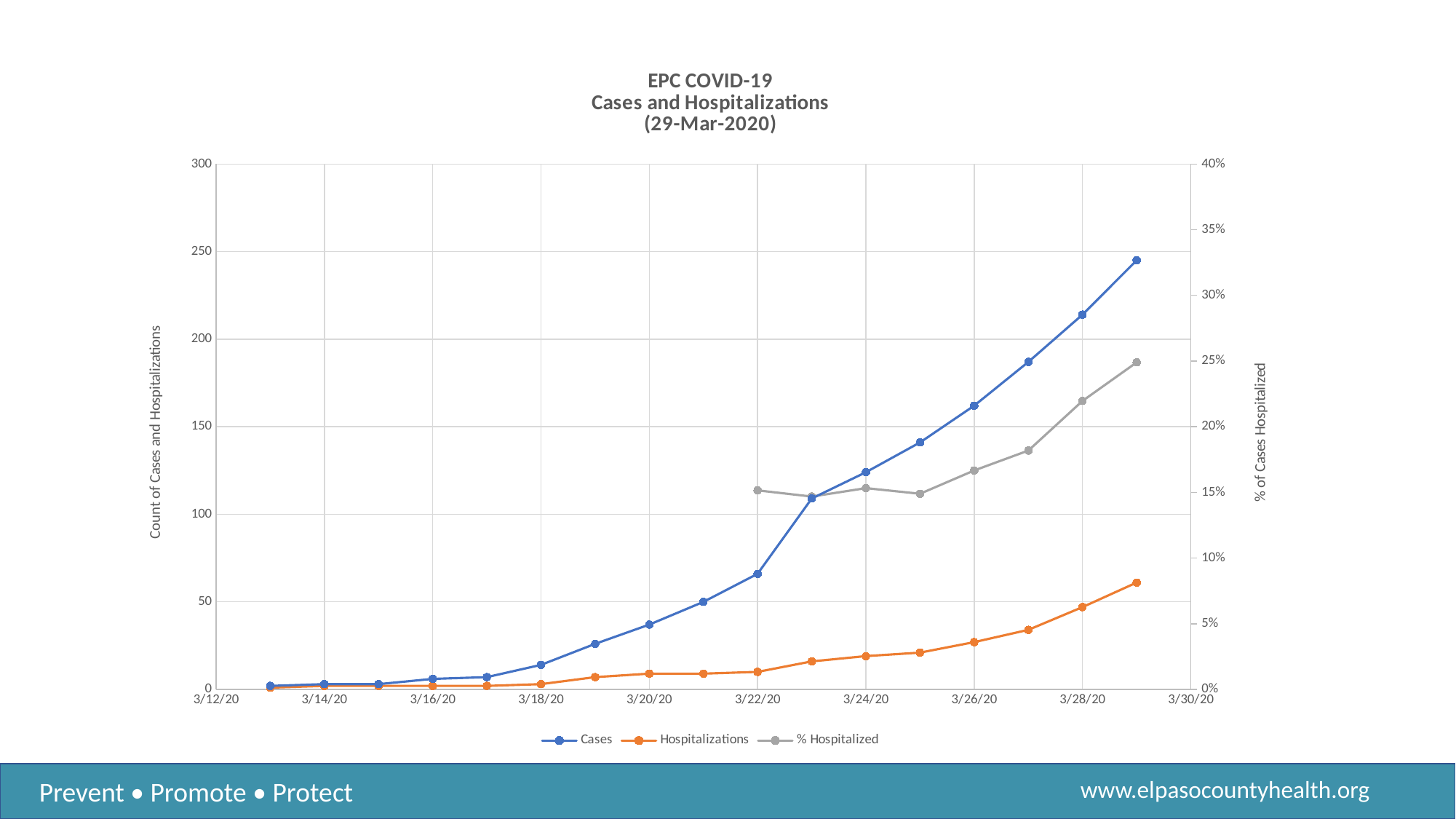
Is the value for Hospitalizations on 3/26/20 greater or less than 50? less On 3/29/20, which is larger: Cases or Hospitalizations? Cases Is the value for Cases on 3/29/20 greater or less than 200? greater What is the label of the right-hand vertical axis? % of Cases Hospitalized Is the value for % Hospitalized on 3/22/20 greater or less than 20%? less Do the Cases values rise or fall from 3/13/20 to 3/29/20? rise What kind of chart is shown on the slide? line chart How many series does the legend list? 3